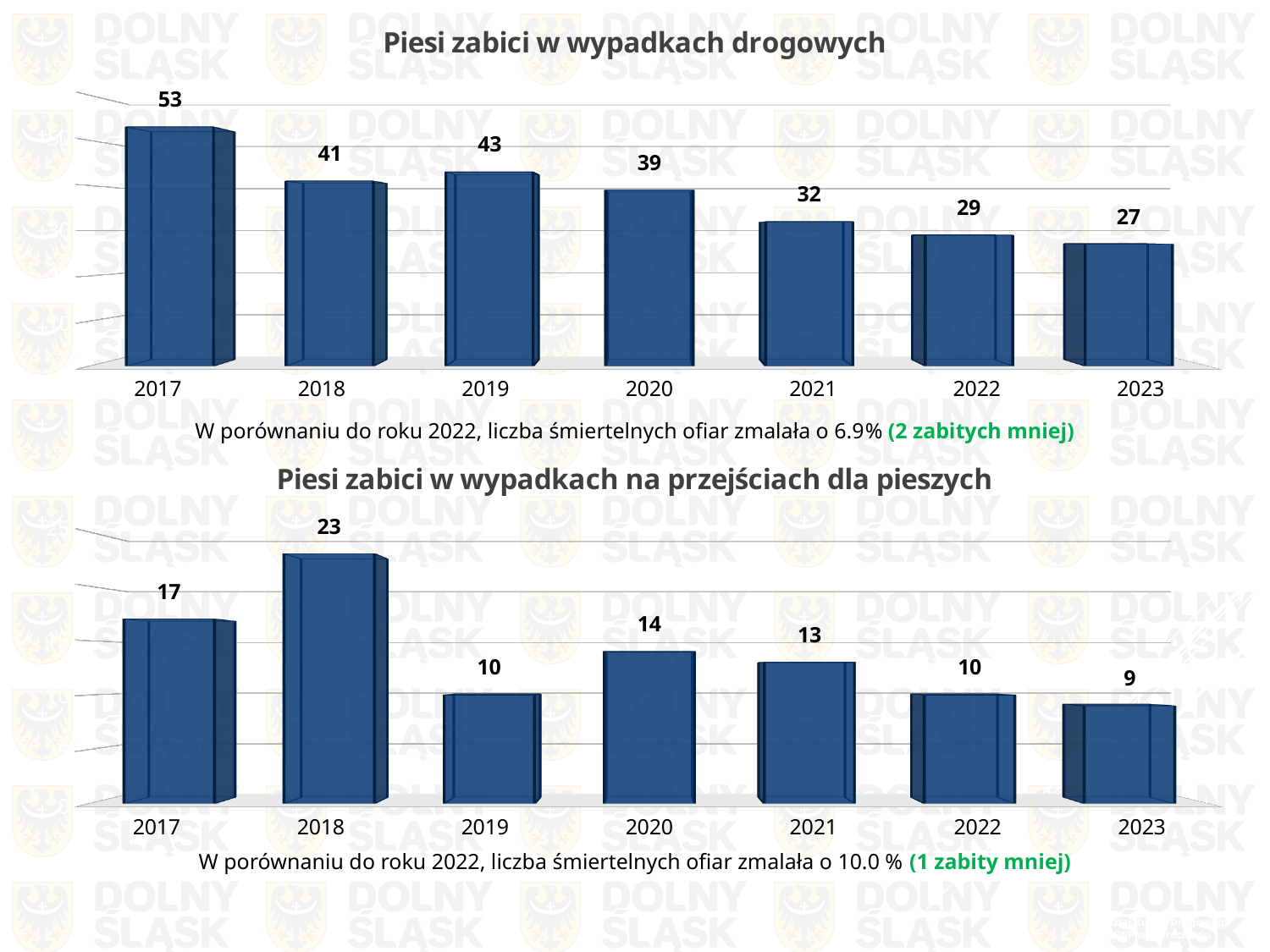
In the chart 'Piesi zabici w wypadkach drogowych', what is the difference between the values for 2017 and 2023? 26 In the chart 'Piesi zabici w wypadkach drogowych', do the values generally rise or fall from 2019 to 2023? fall What kind of chart is the top chart on the slide? bar chart In the chart 'Piesi zabici w wypadkach na przejściach dla pieszych', which year has the highest value? 2018 In the chart 'Piesi zabici w wypadkach drogowych', which is larger, the value for 2018 or the value for 2019? 2019 In the chart 'Piesi zabici w wypadkach na przejściach dla pieszych', what is the value for 2018? 23 In the chart 'Piesi zabici w wypadkach na przejściach dla pieszych', which is larger, the value for 2020 or the value for 2021? 2020 In the chart 'Piesi zabici w wypadkach na przejściach dla pieszych', what is the difference between the values for 2022 and 2023? 1 What is the title of the bottom chart on the slide? Piesi zabici w wypadkach na przejściach dla pieszych In the chart 'Piesi zabici w wypadkach drogowych', what is the value for 2017? 53 In the chart 'Piesi zabici w wypadkach drogowych', which year has the lowest value? 2023 In the chart 'Piesi zabici w wypadkach drogowych', how many years are shown on the x axis? 7